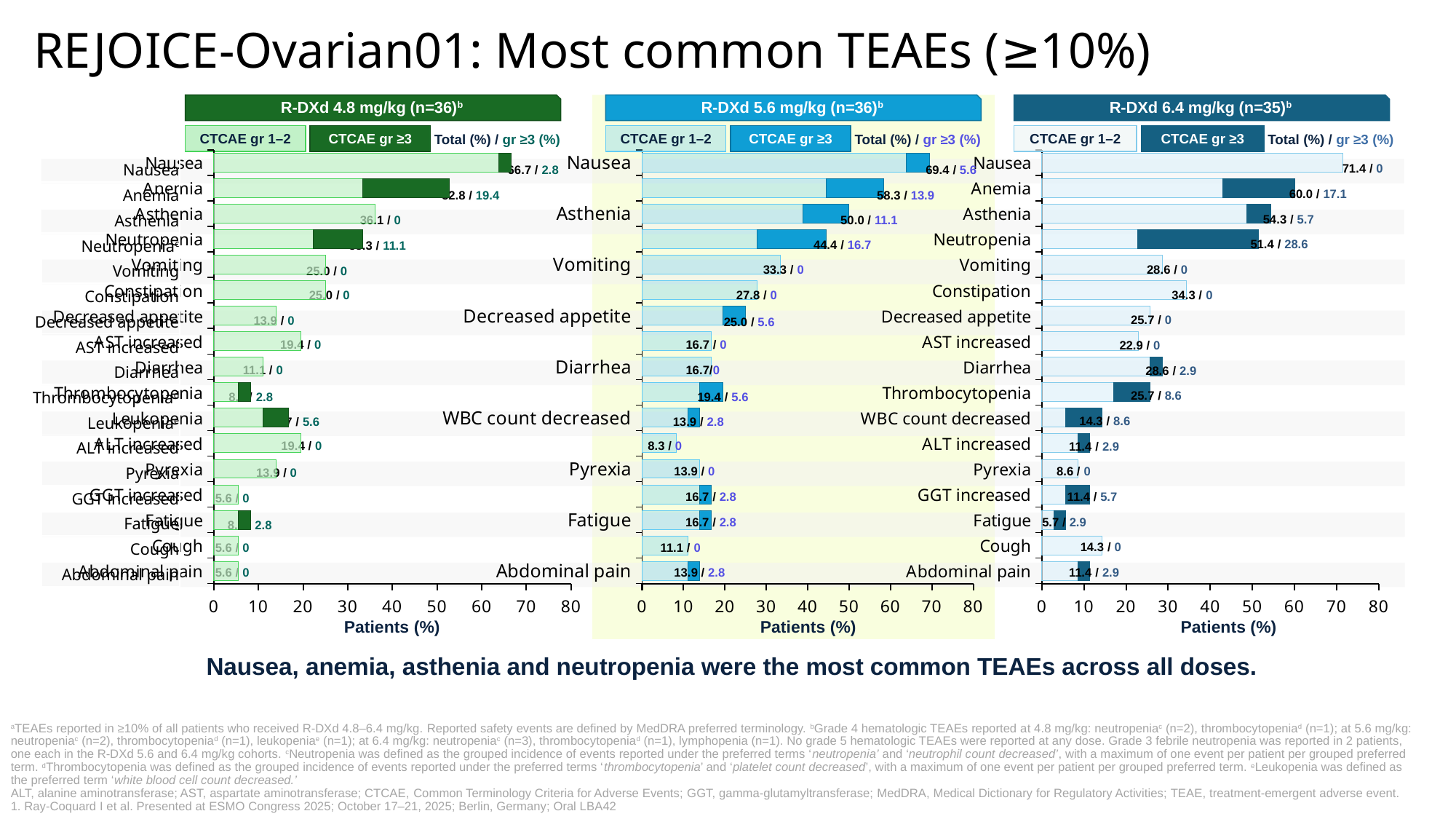
In the R-DXd 6.4 mg/kg chart, what is the total percentage of patients with nausea? 71.4 How many TEAE categories are listed in the R-DXd 5.6 mg/kg chart? 17 In the R-DXd 5.6 mg/kg chart, which TEAE has the lowest total percentage? ALT increased In the R-DXd 6.4 mg/kg chart, is the total percentage for constipation or vomiting larger? Constipation In the R-DXd 5.6 mg/kg chart, what is the grade ≥3 percentage for neutropenia? 16.7 In the R-DXd 6.4 mg/kg chart, which TEAE has the highest total percentage? Nausea In the R-DXd 4.8 mg/kg chart, what is the total percentage for anemia? 52.8 How many series does the legend of the R-DXd 6.4 mg/kg chart list? 2 In the R-DXd 6.4 mg/kg chart, which TEAE has the highest grade ≥3 percentage? Neutropenia What type of chart is used for the R-DXd 4.8 mg/kg data? Stacked bar chart In the R-DXd 5.6 mg/kg chart, what is the difference between the total percentages for nausea and anemia? 11.1 In the R-DXd 4.8 mg/kg chart, is the total percentage for asthenia greater or less than 30? greater